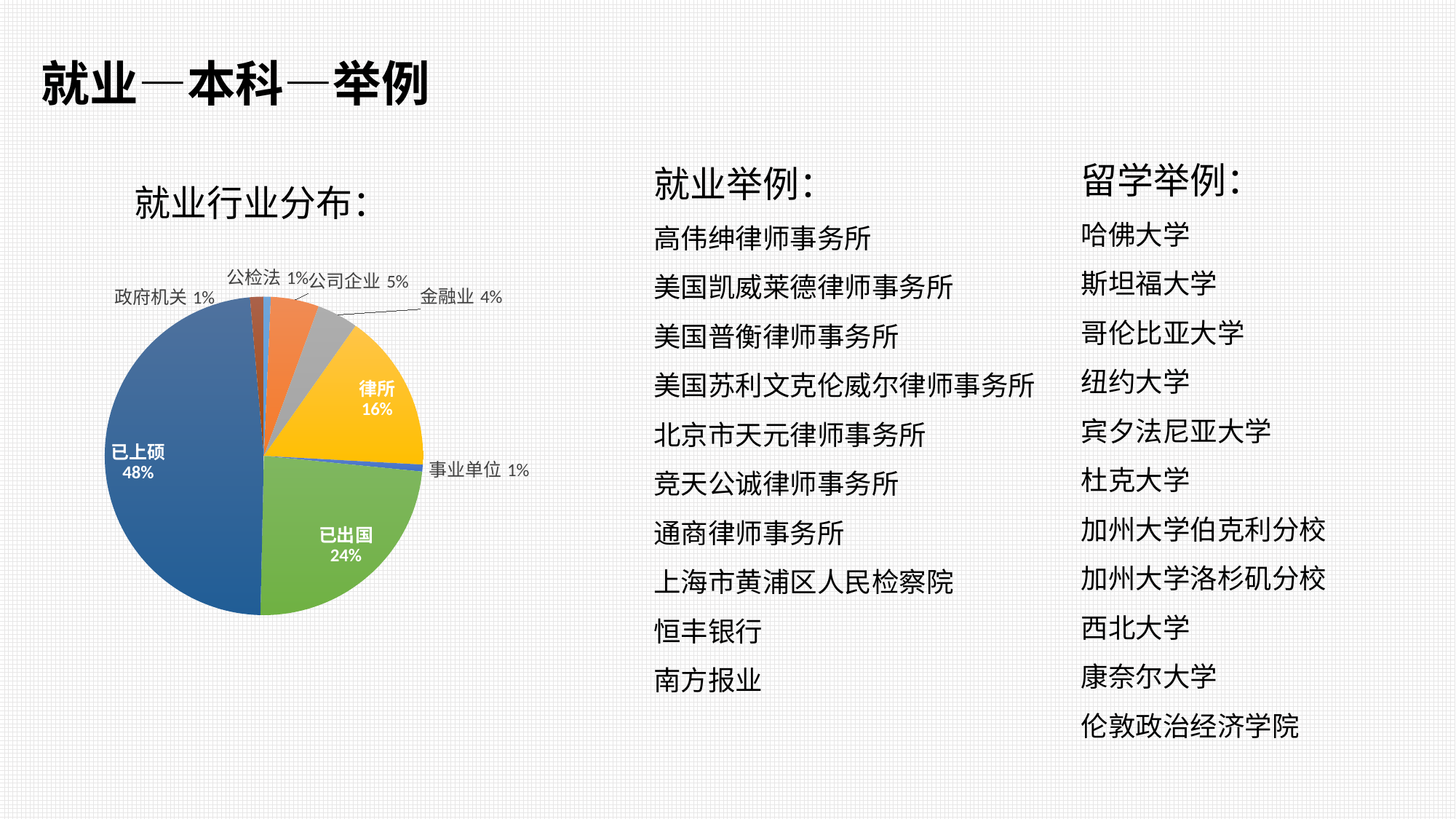
What is the share for 律所 in the pie chart? 16% What is the share for 公司企业 in the pie chart? 5% What kind of chart is shown on the slide? pie chart What is the share for 已上硕 in the pie chart? 48% What is the share for 已出国 in the pie chart? 24% Which is larger in the pie chart, 公司企业 or 金融业? 公司企业 What is the difference between the shares of 已上硕 and 已出国? 24% How many slices does the pie chart have? 8 What is the share for 金融业 in the pie chart? 4% What is the title of the pie chart? 就业行业分布 Which category has the largest slice in the pie chart? 已上硕 What is the difference between the shares of 律所 and 金融业? 12%